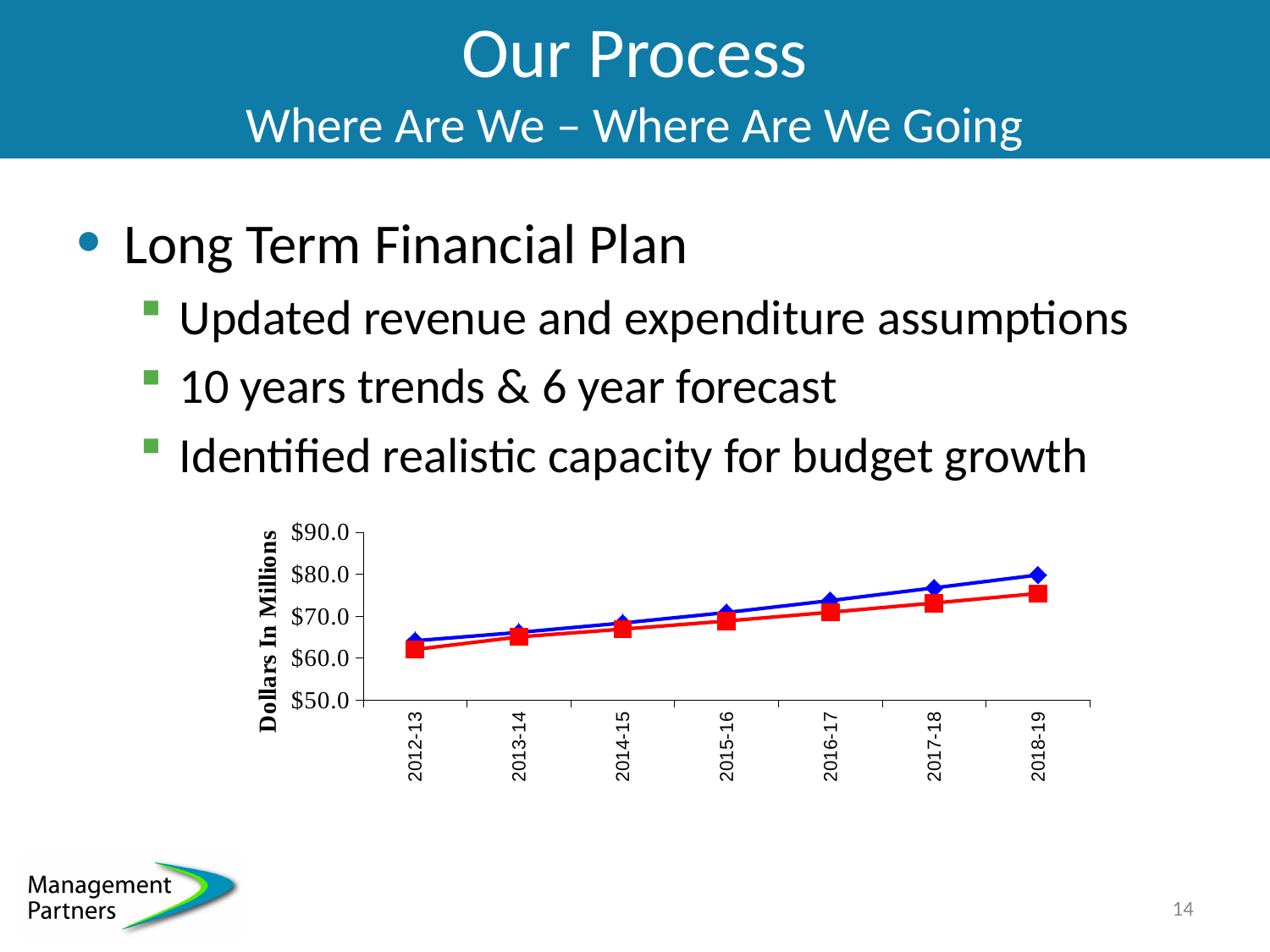
What is the first fiscal year shown on the x axis of the chart? 2012-13 How many fiscal years are plotted along the x axis of the chart? 7 What is the title of the vertical axis of the chart? Dollars In Millions Is the value of the red line for 2018-19 greater or less than $80.0? less Is the value of the blue line for 2012-13 greater or less than $70.0? less How many lines (series) are plotted on the chart? 2 What kind of chart is shown on the slide? line chart Do the values of the red line rise or fall across the years shown? rise Is the value of the red line for 2018-19 greater or less than $70.0? greater In 2018-19, which line has the higher value, the blue line or the red line? the blue line Do the values of the blue line rise or fall from 2012-13 to 2018-19? rise